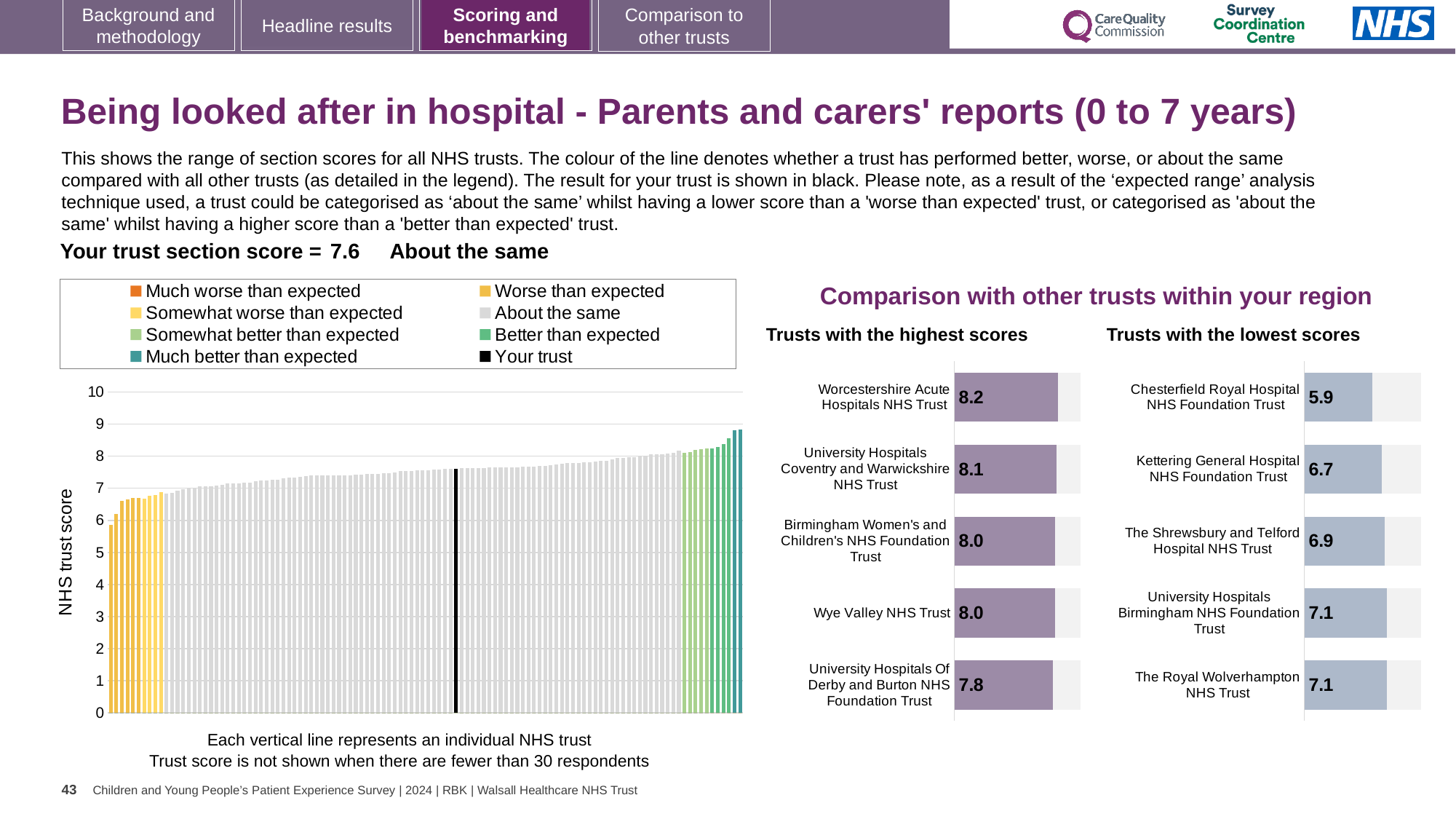
In the 'Trusts with the highest scores' chart, what is the difference between the scores of Worcestershire Acute Hospitals NHS Trust and University Hospitals Of Derby and Burton NHS Foundation Trust? 0.4 In the 'Trusts with the lowest scores' chart, which trust has the lowest score? Chesterfield Royal Hospital NHS Foundation Trust In the 'Trusts with the lowest scores' chart, what is the score for Kettering General Hospital NHS Foundation Trust? 6.7 In the main NHS trust score chart on the left, do the trust scores rise or fall from left to right? Rise In the 'Trusts with the highest scores' chart, what is the score for Worcestershire Acute Hospitals NHS Trust? 8.2 How many entries does the legend of the main NHS trust score chart on the left list? 8 How many trusts are listed in the 'Trusts with the highest scores' chart? 5 In the 'Trusts with the lowest scores' chart, what is the difference between the scores of The Royal Wolverhampton NHS Trust and Chesterfield Royal Hospital NHS Foundation Trust? 1.2 In the 'Trusts with the highest scores' chart, which trust has the highest score? Worcestershire Acute Hospitals NHS Trust In the 'Trusts with the lowest scores' chart, which has the higher score: Kettering General Hospital NHS Foundation Trust or The Shrewsbury and Telford Hospital NHS Trust? The Shrewsbury and Telford Hospital NHS Trust In the main NHS trust score chart on the left, is the value for the black 'Your trust' bar greater or less than 7? greater What kind of chart is the main chart on the left showing NHS trust scores? Bar chart